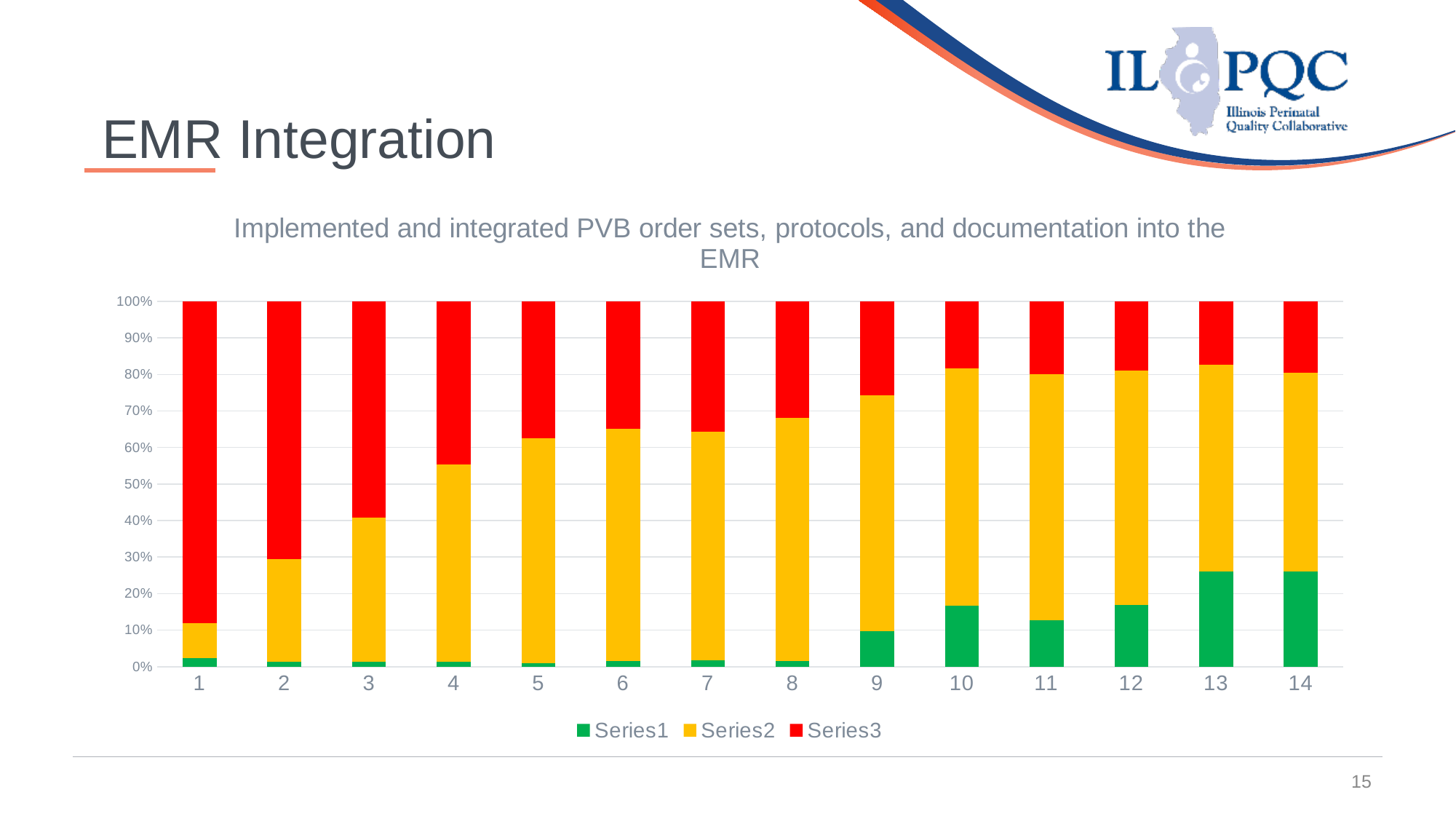
Is the Series3 segment larger for category 1 or category 14? Category 1 Is the Series3 value for category 1 greater or less than 80%? greater Is the Series1 value for category 13 greater or less than 20%? greater What is the total height of the stacked bar for category 1? 100% What is the title of the chart? Implemented and integrated PVB order sets, protocols, and documentation into the EMR Does the Series3 (red) share generally rise or fall from category 1 to category 14? Fall Which category has the smallest Series2 (yellow) segment? 1 How many series does the chart legend list? 3 What kind of chart is shown on the slide? Stacked bar chart Which category has the largest Series3 (red) segment? 1 Which colour represents Series3 in the chart? Red How many categories are shown along the x axis of the chart? 14